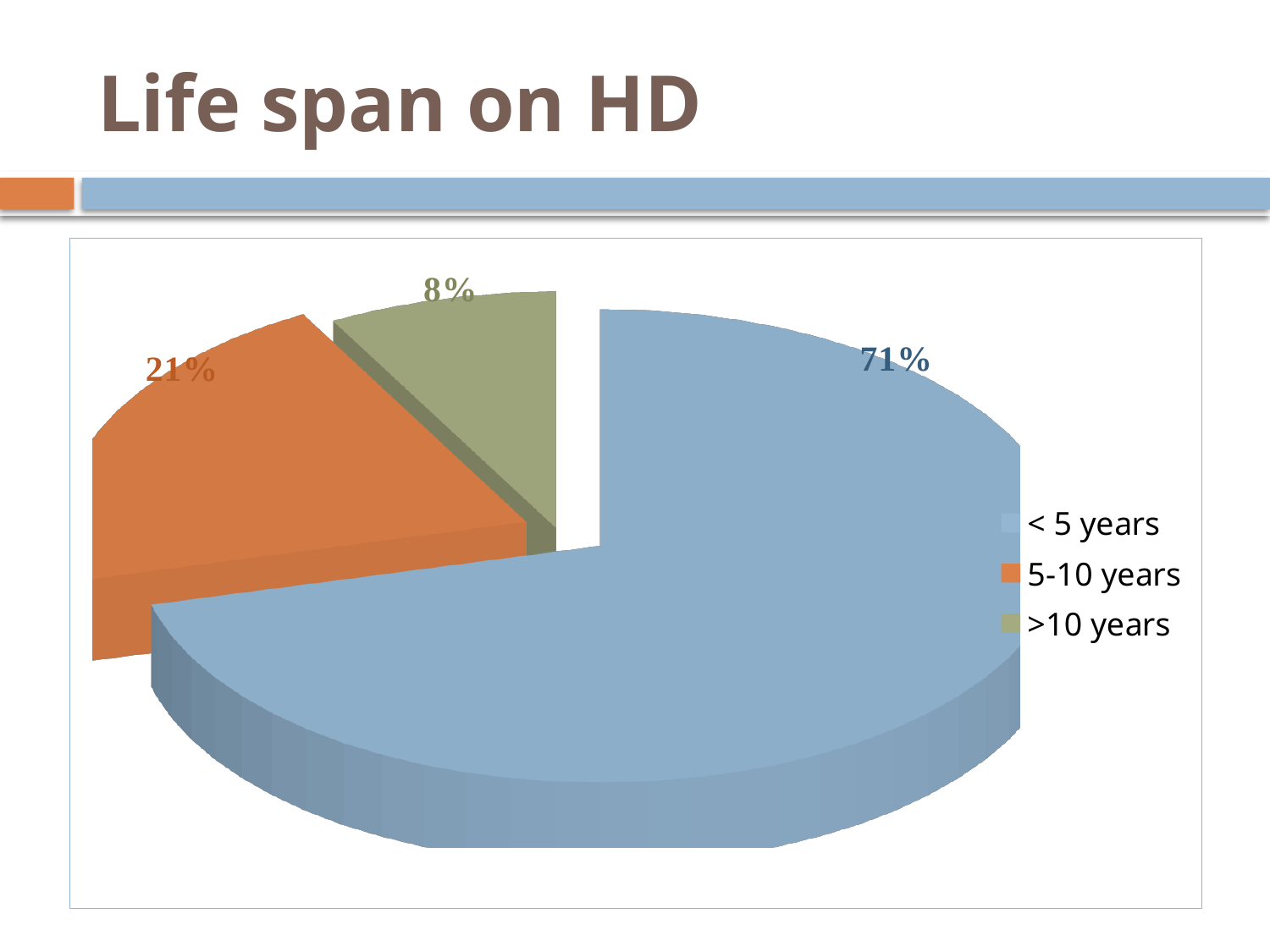
What is the title of the slide containing the pie chart? Life span on HD Which category has the largest slice of the pie? < 5 years What share of the pie is labelled for the '< 5 years' slice? 71% Which category has the smallest slice of the pie? >10 years What share of the pie is labelled for the '5-10 years' slice? 21% What share of the pie is labelled for the '>10 years' slice? 8% What colour is the '5-10 years' slice in the pie chart? orange How many entries does the legend list? 3 What is the difference in percentage points between the '< 5 years' slice and the '5-10 years' slice? 50 Which slice is larger, '5-10 years' or '>10 years'? 5-10 years How many slices does the pie chart have? 3 What kind of chart is shown on the slide? pie chart